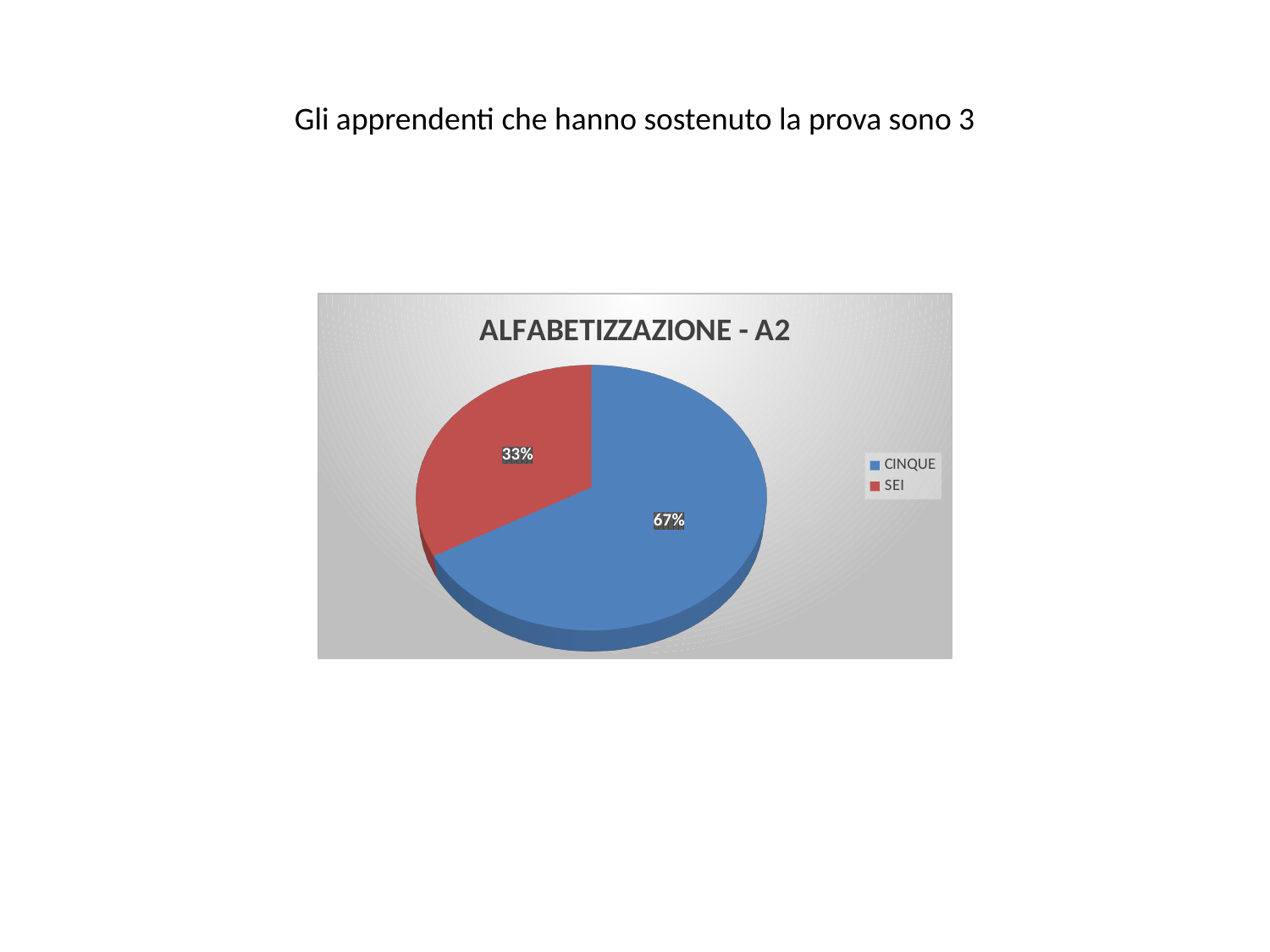
What is the title of the chart? ALFABETIZZAZIONE - A2 What is the difference in percentage points between the CINQUE slice and the SEI slice? 34 How many categories does the legend list? 2 Which category has the smallest slice of the pie? SEI What percentage of the pie does the CINQUE slice represent? 67% What kind of chart is shown on the slide? pie chart Which category has the largest slice of the pie? CINQUE Which slice is larger, CINQUE or SEI? CINQUE What percentage of the pie does the SEI slice represent? 33% What colour is the CINQUE slice? blue Is the share for SEI greater or less than 50%? less